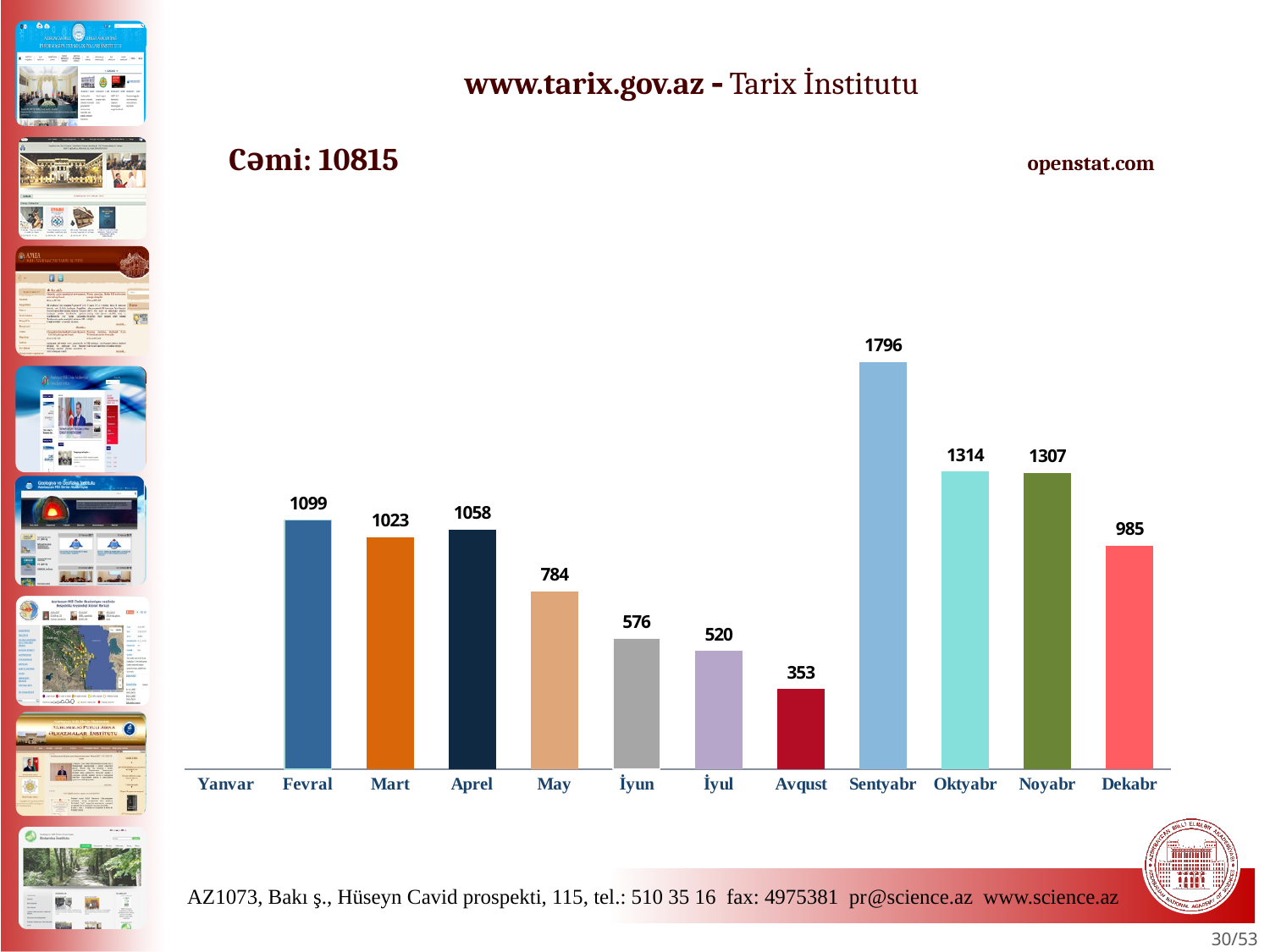
Which month has the lowest plotted value? Avqust What total (Cəmi) is stated on the slide? 10815 Which is larger, the value for Mart or the value for Aprel? Aprel Do the values rise or fall from Aprel to Avqust? Fall Which month has the highest value? Sentyabr What is the value for Dekabr? 985 What kind of chart is shown on the slide? Bar chart What is the difference between the values for Sentyabr and Oktyabr? 482 What is the value for Avqust? 353 What is the value for Sentyabr? 1796 How many bars are plotted on the chart? 11 What is the value for Fevral? 1099